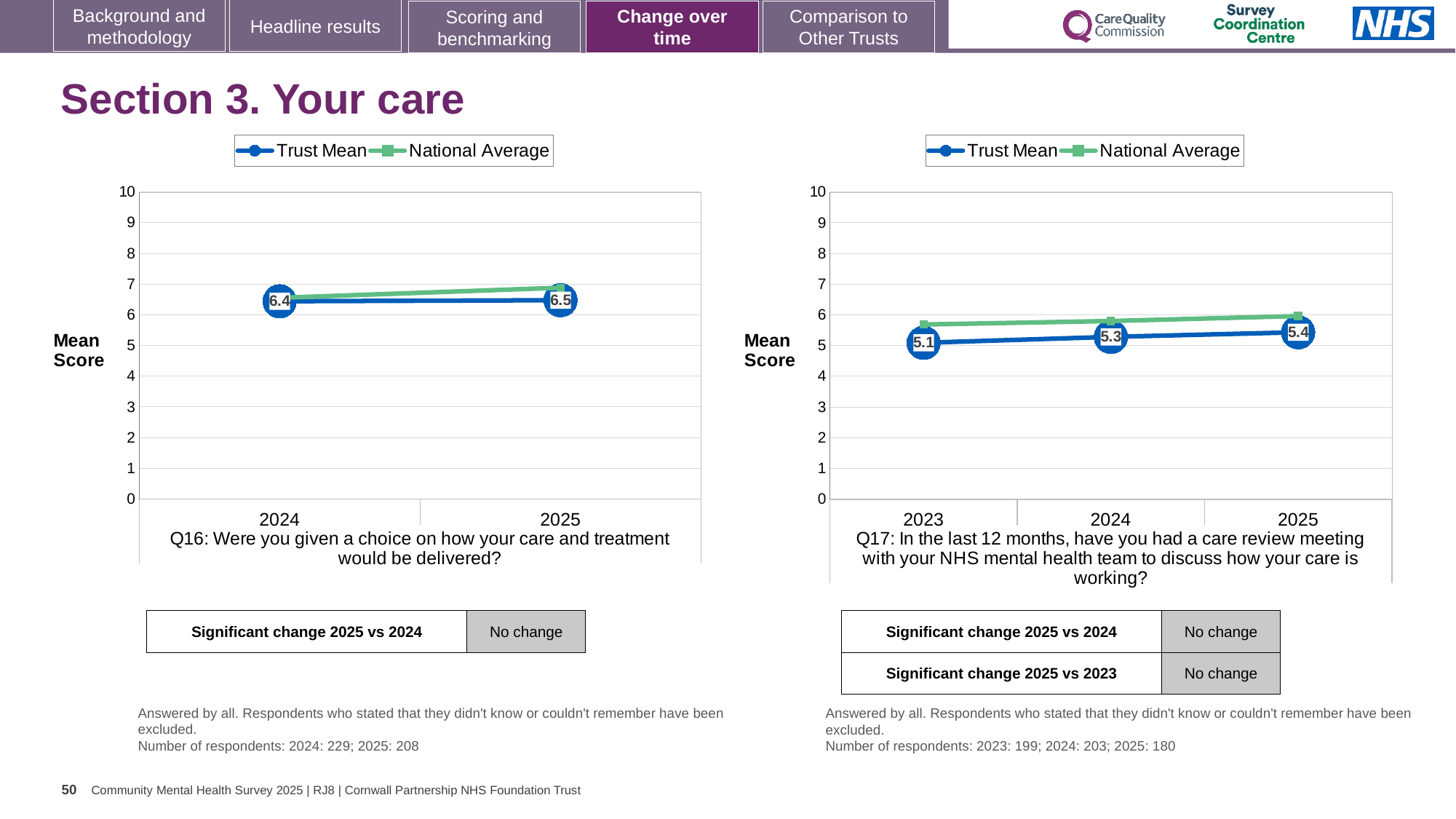
How many series does the legend of the left chart (Q16) list? 2 In the left chart (Q16), what is the Trust Mean for 2025? 6.5 In the right chart (Q17), what is the Trust Mean for 2023? 5.1 What type of chart is the left chart (Q16)? Line chart In the right chart (Q17), which year has the highest Trust Mean? 2025 In the right chart (Q17), is the National Average for 2025 greater or less than 5? greater In the right chart (Q17), what is the Trust Mean for 2025? 5.4 In the left chart (Q16), is the Trust Mean higher in 2024 or 2025? 2025 In the right chart (Q17), what is the difference between the Trust Mean for 2025 and 2023? 0.3 How many years are shown on the x axis of the right chart (Q17)? 3 In the right chart (Q17), which year has the lowest Trust Mean? 2023 In the left chart (Q16), what is the Trust Mean for 2024? 6.4